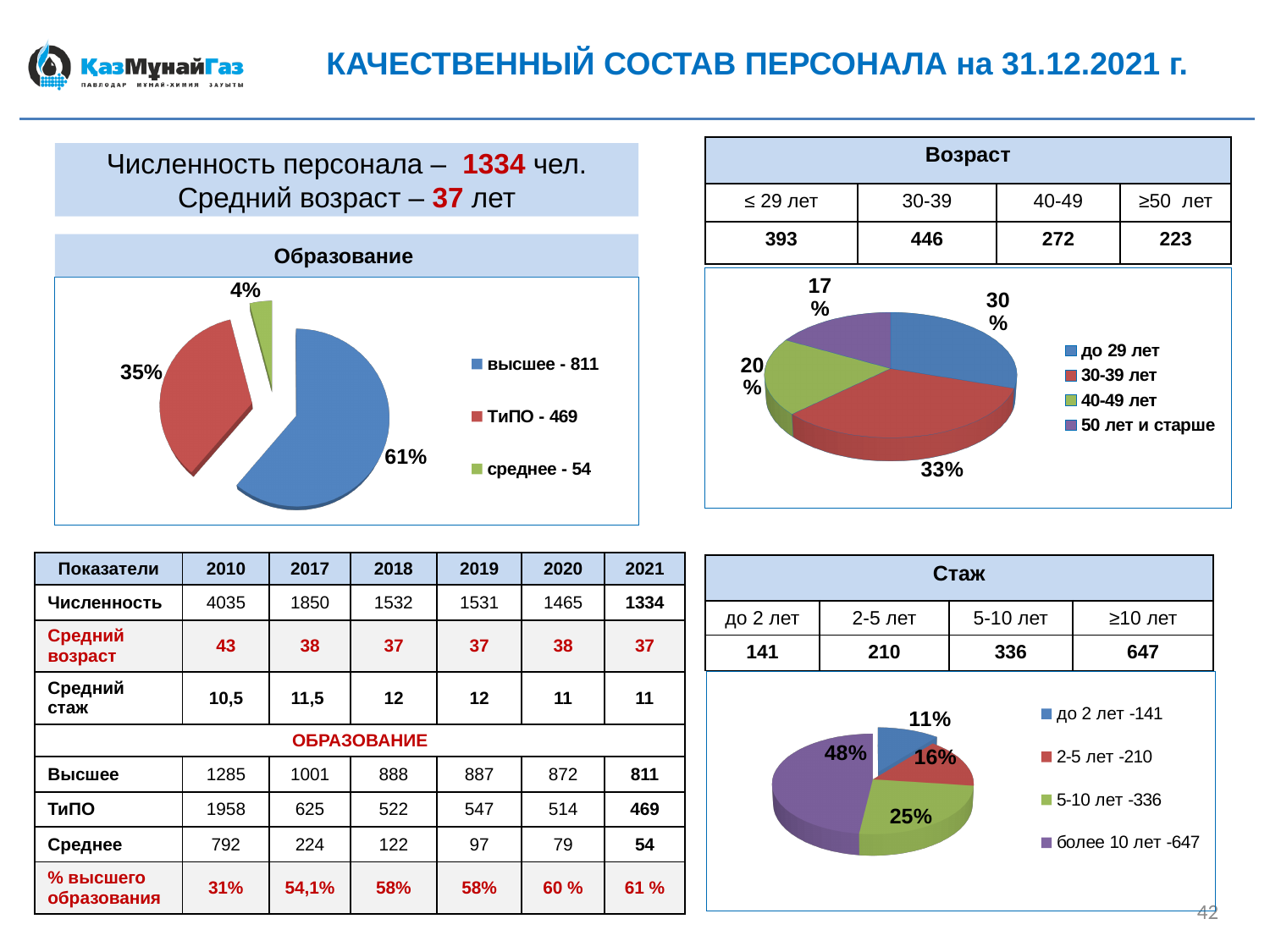
In the "Образование" pie chart, which category has the smallest slice? среднее - 54 In the "Возраст" pie chart, what share of the pie does the "30-39 лет" slice have? 33% In the "Образование" pie chart, what share of the pie does the "среднее - 54" slice have? 4% What type of chart is used in the "Возраст" section of the slide? pie chart In the "Возраст" pie chart, what is the difference in percentage points between the "до 29 лет" slice and the "40-49 лет" slice? 10 In the "Стаж" pie chart, which is larger: the "2-5 лет -210" slice or the "5-10 лет -336" slice? 5-10 лет -336 In the "Образование" pie chart, which category has the largest slice? высшее - 811 How many slices does the "Образование" pie chart have? 3 How many entries does the legend of the "Стаж" pie chart list? 4 In the "Образование" pie chart, what share of the pie does the "высшее - 811" slice have? 61% In the "Возраст" pie chart, which category has the smallest slice? 50 лет и старше